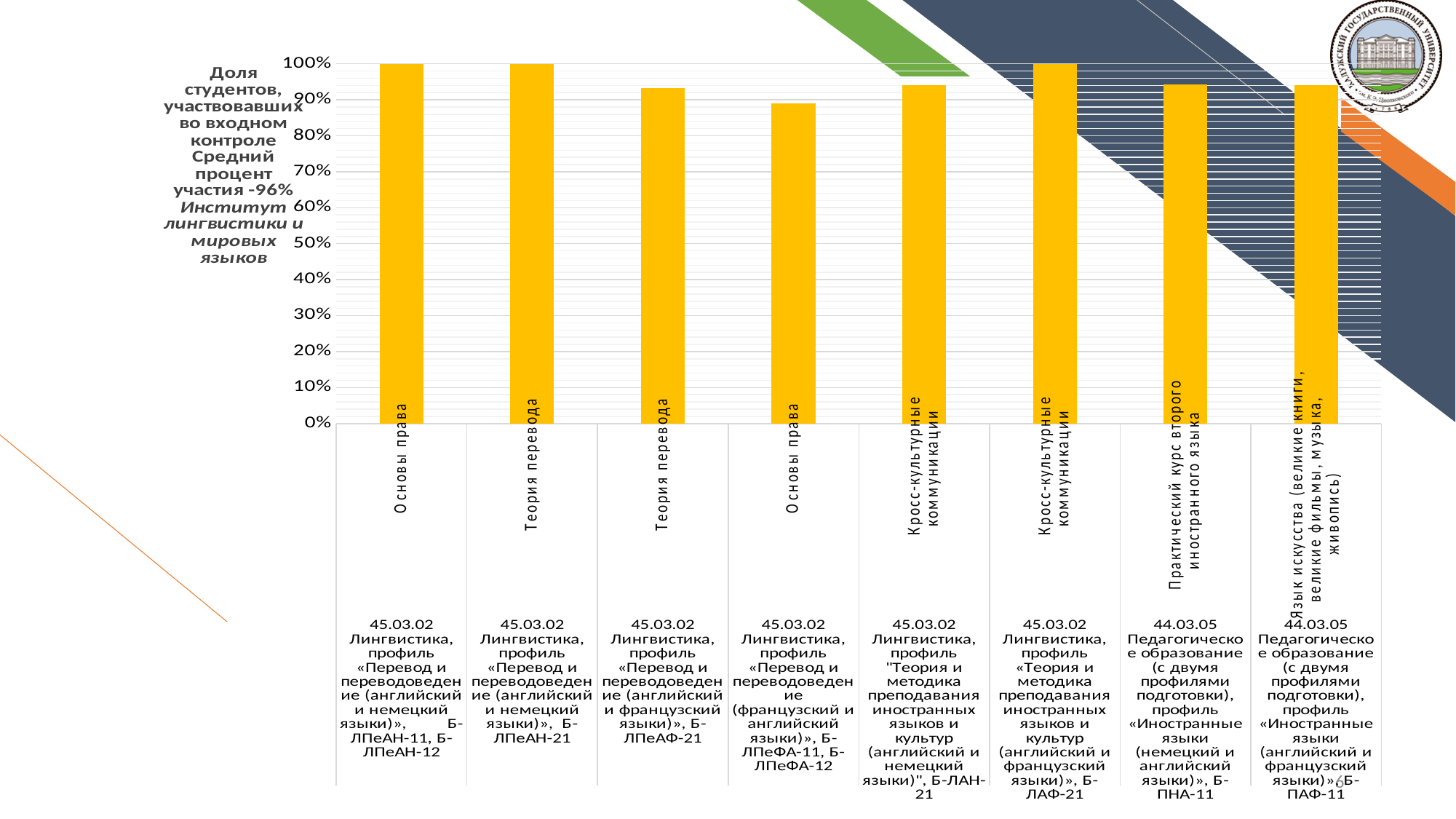
What is the value for Кросс-культурные коммуникации in group Б-ЛАФ-21? 100% Which category has the lowest bar? Основы права (Б-ЛПеФА-11, Б-ЛПеФА-12) What kind of chart is shown on the slide? bar chart Which is larger: the value for Теория перевода in group Б-ЛПеАН-21 or in group Б-ЛПеАФ-21? Б-ЛПеАН-21 Is the value for Практический курс второго иностранного языка (Б-ПНА-11) greater or less than 90%? greater Is the value for Теория перевода in group Б-ЛПеАФ-21 greater or less than 90%? greater How many bars reach 100%? 3 How many bars (categories) does the chart show? 8 Is the value for Основы права in group Б-ЛПеФА-11, Б-ЛПеФА-12 greater or less than 90%? less What is the value for Основы права in group Б-ЛПеАН-11, Б-ЛПеАН-12? 100% According to the chart title, what is the average participation percentage (средний процент участия)? 96% What is the value for Теория перевода in group Б-ЛПеАН-21? 100%